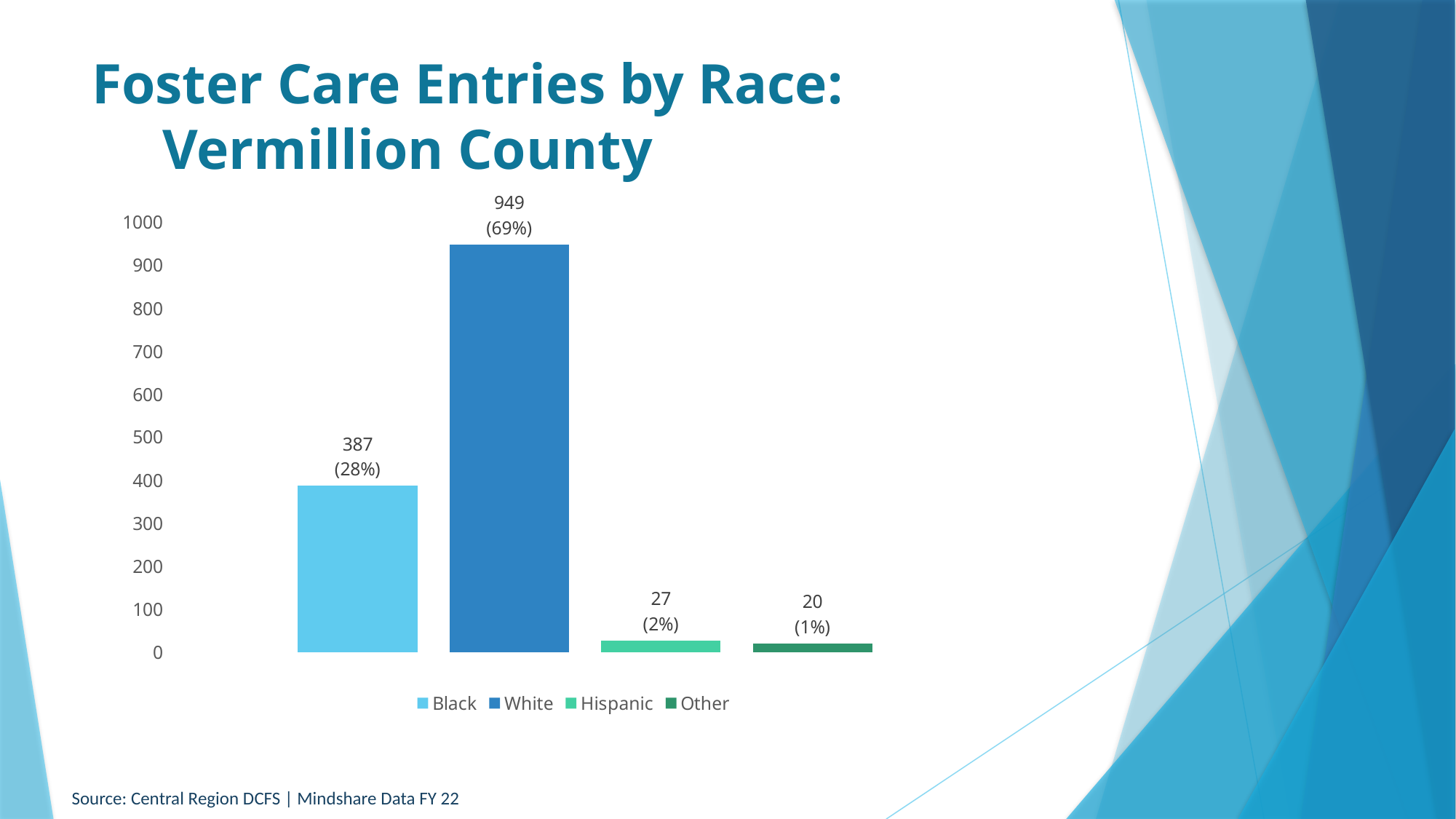
What kind of chart is shown on the slide? Bar chart Which has more foster care entries, Hispanic or Other? Hispanic How many race categories are plotted in the chart? 4 Which race has the highest number of foster care entries? White Which race has the lowest number of foster care entries? Other Is the value for Black greater or less than 400? less What is the difference between the White and Black foster care entries? 562 How many foster care entries are shown for White? 949 How many foster care entries are shown for Black? 387 What percentage of foster care entries is labelled for Other? 1% How many foster care entries are shown for Hispanic? 27 What is the source cited at the bottom of the slide? Central Region DCFS | Mindshare Data FY 22